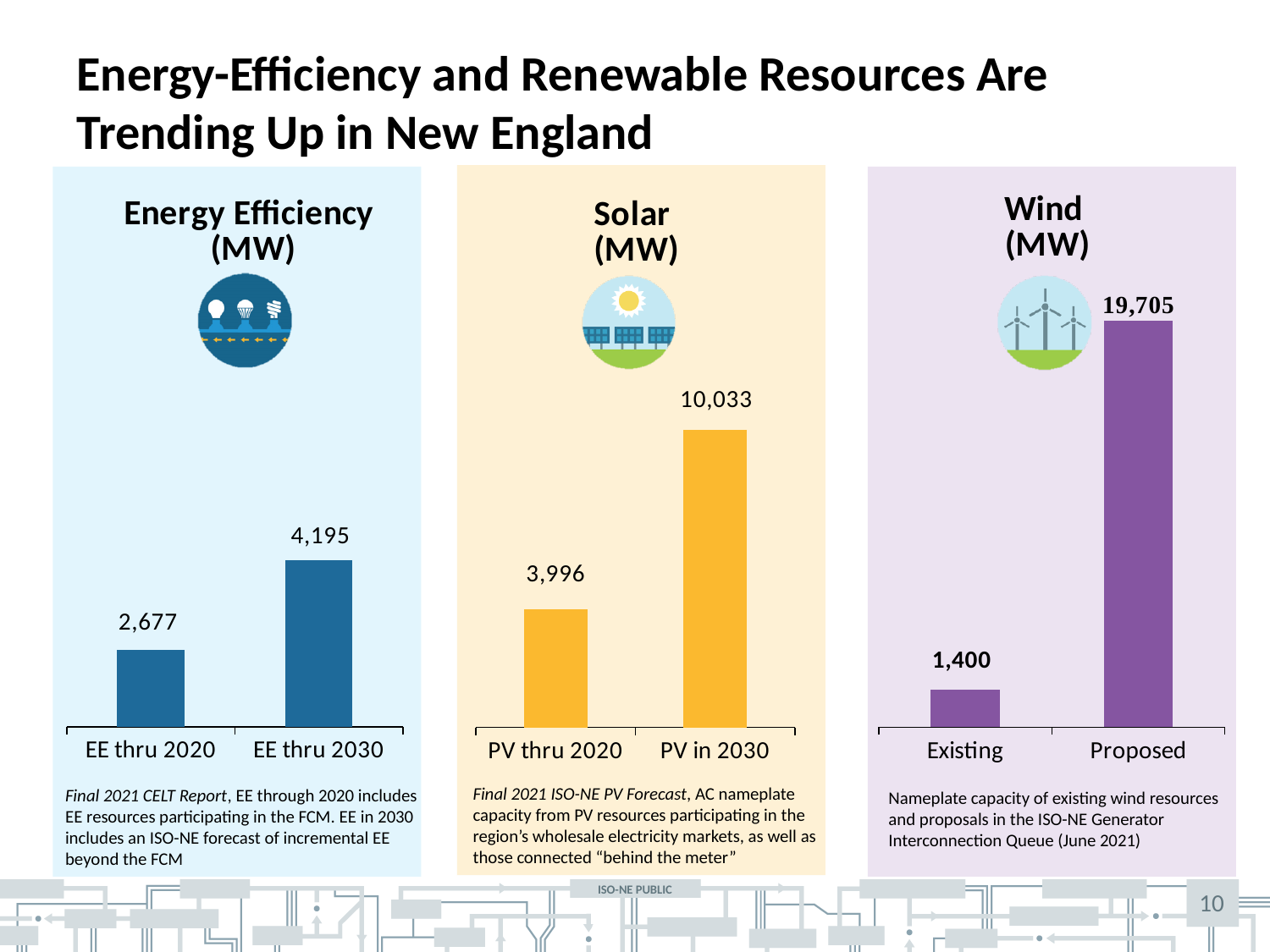
What kind of chart is the Energy Efficiency (MW) chart? Bar chart In the Energy Efficiency (MW) chart, what is the difference between EE thru 2030 and EE thru 2020? 1,518 In the Wind (MW) chart, what is the value for Proposed? 19,705 In the Wind (MW) chart, what is the value for Existing? 1,400 How many bars are in the Solar (MW) chart? 2 In the Wind (MW) chart, what is the difference between Proposed and Existing? 18,305 In the Solar (MW) chart, what is the value for PV in 2030? 10,033 In the Wind (MW) chart, which category has the lowest value? Existing In the Solar (MW) chart, which category has the higher value? PV in 2030 In the Energy Efficiency (MW) chart, what is the value for EE thru 2030? 4,195 In the Solar (MW) chart, what is the value for PV thru 2020? 3,996 In the Energy Efficiency (MW) chart, what is the value for EE thru 2020? 2,677